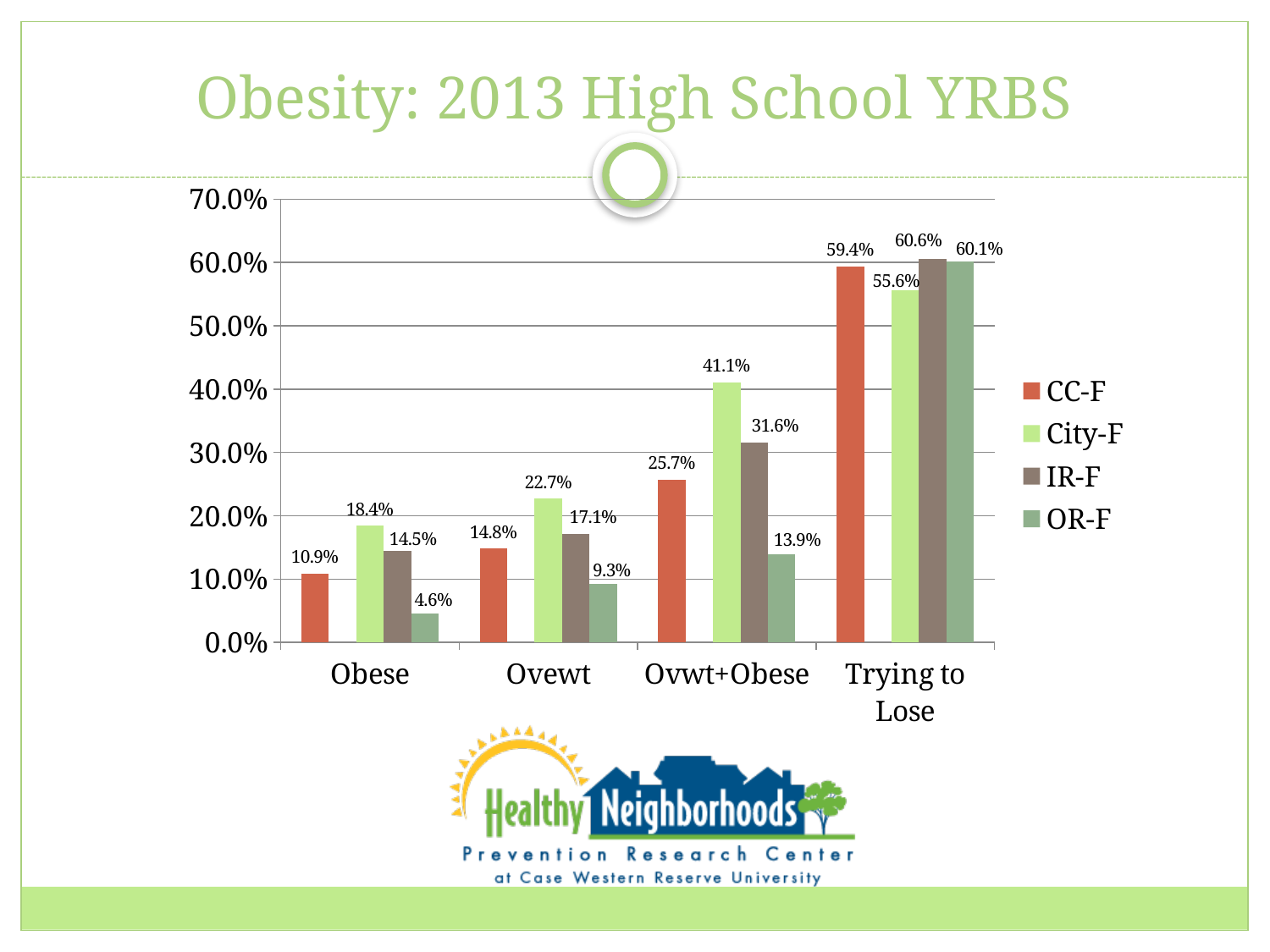
What is the value for OR-F in the Ovewt category? 9.3% What is the difference between the City-F and OR-F values in the Ovwt+Obese category? 27.2% Which series has the highest value in the Ovwt+Obese category? City-F How many categories are shown on the x axis? 4 Is the value for CC-F in the Trying to Lose category greater or less than 50.0%? greater What is the value for City-F in the Obese category? 18.4% What is the title of the slide? Obesity: 2013 High School YRBS What is the value for IR-F in the Trying to Lose category? 60.6% What kind of chart is shown on the slide? bar chart Which is larger in the Ovewt category, CC-F or IR-F? IR-F How many series does the legend list? 4 Which series has the lowest value in the Obese category? OR-F